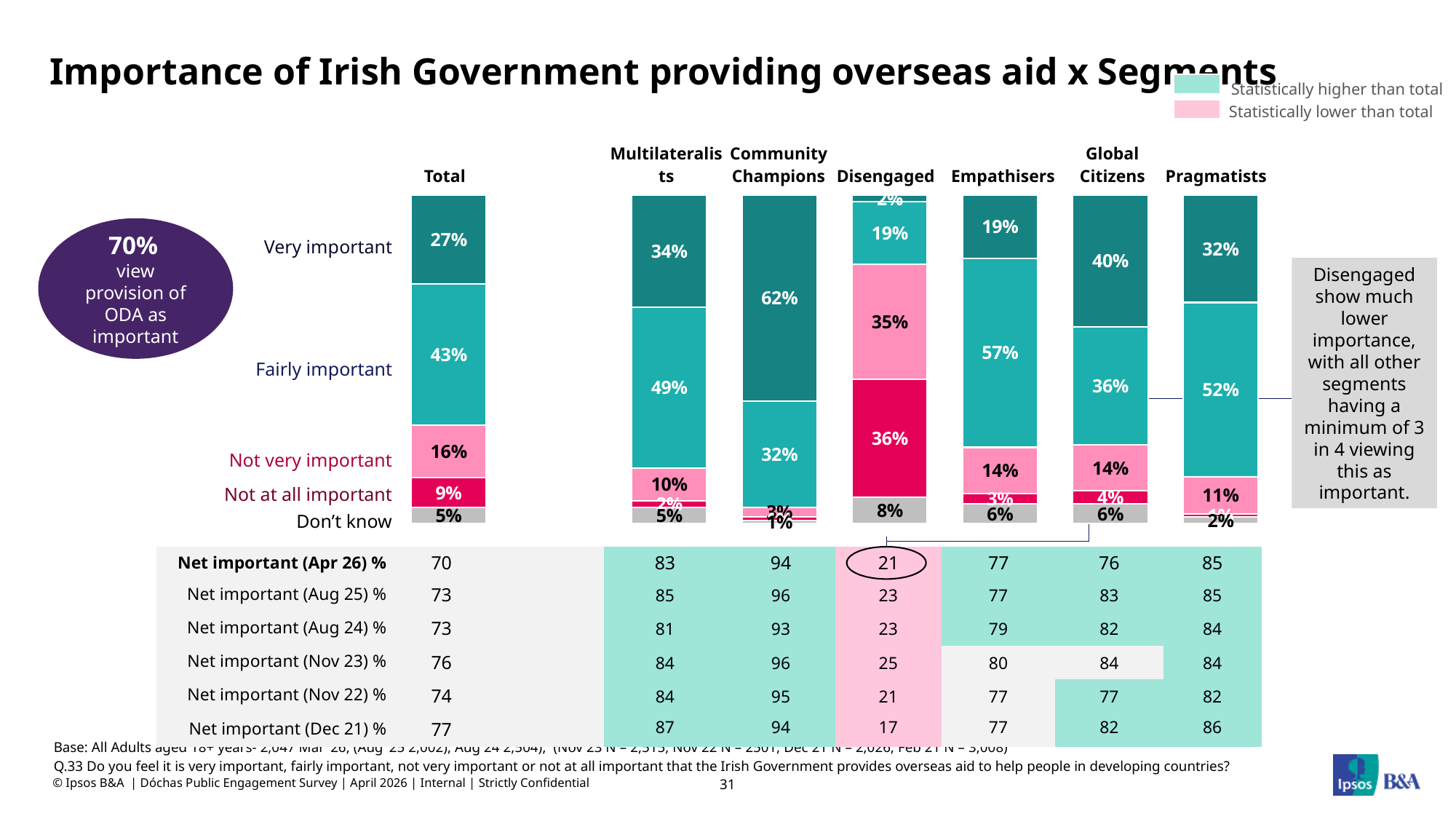
What kind of chart is used to show the importance ratings by segment? Stacked bar chart What percentage of the Disengaged segment say providing overseas aid is Not at all important? 36% What percentage of the Total say providing overseas aid is Very important? 27% Which segment has the lowest Net important (Apr 26) % value? Disengaged How many segment bars, including Total, are shown in the chart? 7 Which is larger: the Fairly important percentage for Multilateralists or for Pragmatists? Pragmatists What percentage of Community Champions say providing overseas aid is Very important? 62% Which segment has the highest Very important percentage? Community Champions What percentage of Empathisers say providing overseas aid is Fairly important? 57% What is the difference between the Very important percentages for Global Citizens and Pragmatists? 8% What is the Net important (Apr 26) % value for Multilateralists? 83 What percentage of the Total answered Don't know? 5%